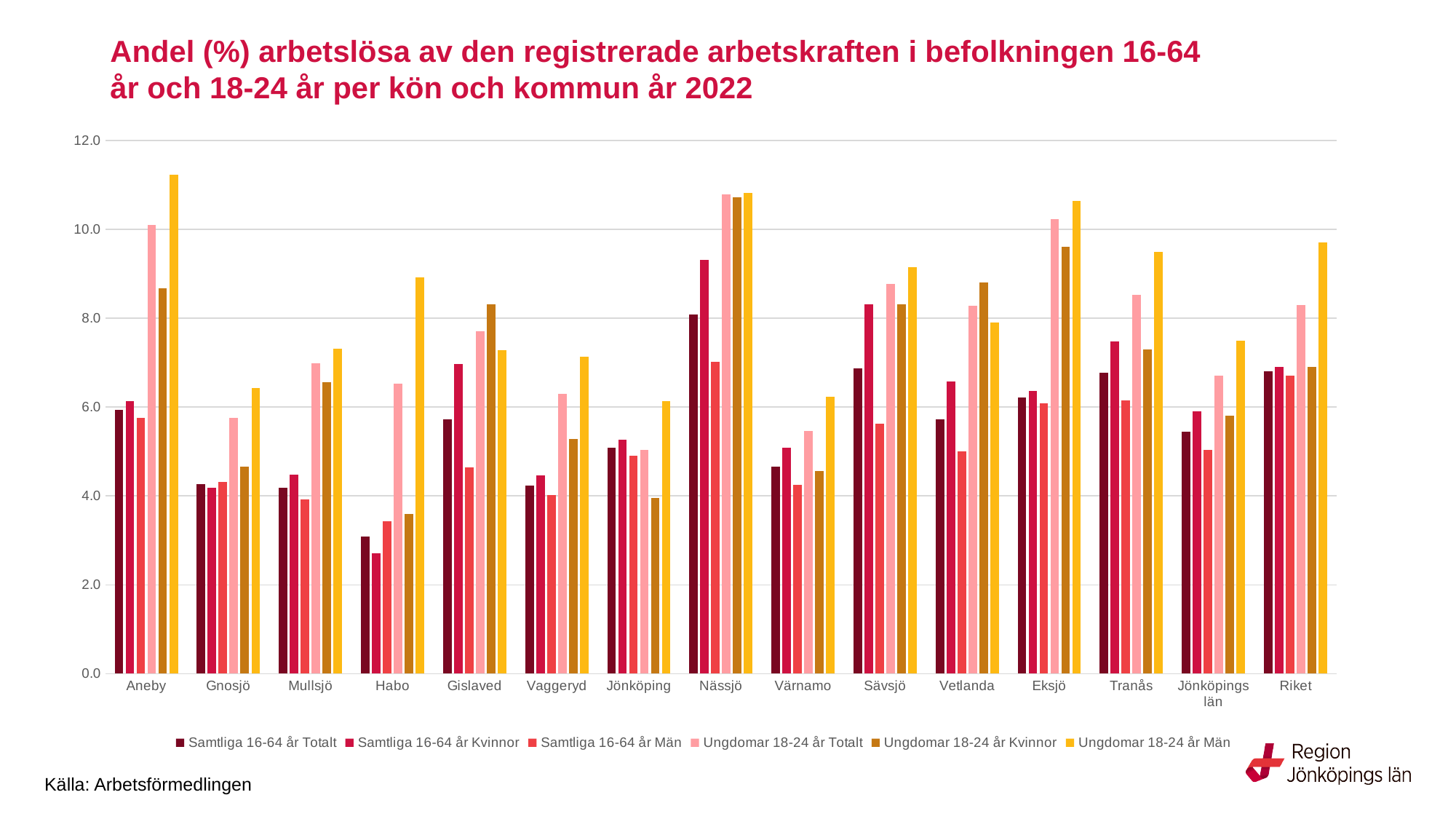
What kind of chart is shown on the slide? Bar chart Which category has the lowest value for Samtliga 16-64 år Kvinnor? Habo Which category has the highest value for Ungdomar 18-24 år Män? Aneby Is the value for Ungdomar 18-24 år Totalt in Nässjö greater or less than 10.0? greater How many municipalities/regions are shown along the x axis? 15 What source is cited below the chart? Arbetsförmedlingen How many series does the legend list? 6 Which category has the lowest value for Samtliga 16-64 år Totalt? Habo Which category has the highest value for Samtliga 16-64 år Totalt? Nässjö Is the value for Samtliga 16-64 år Totalt in Habo greater or less than 4.0? less Which is larger: the Samtliga 16-64 år Totalt value for Nässjö or for Habo? Nässjö